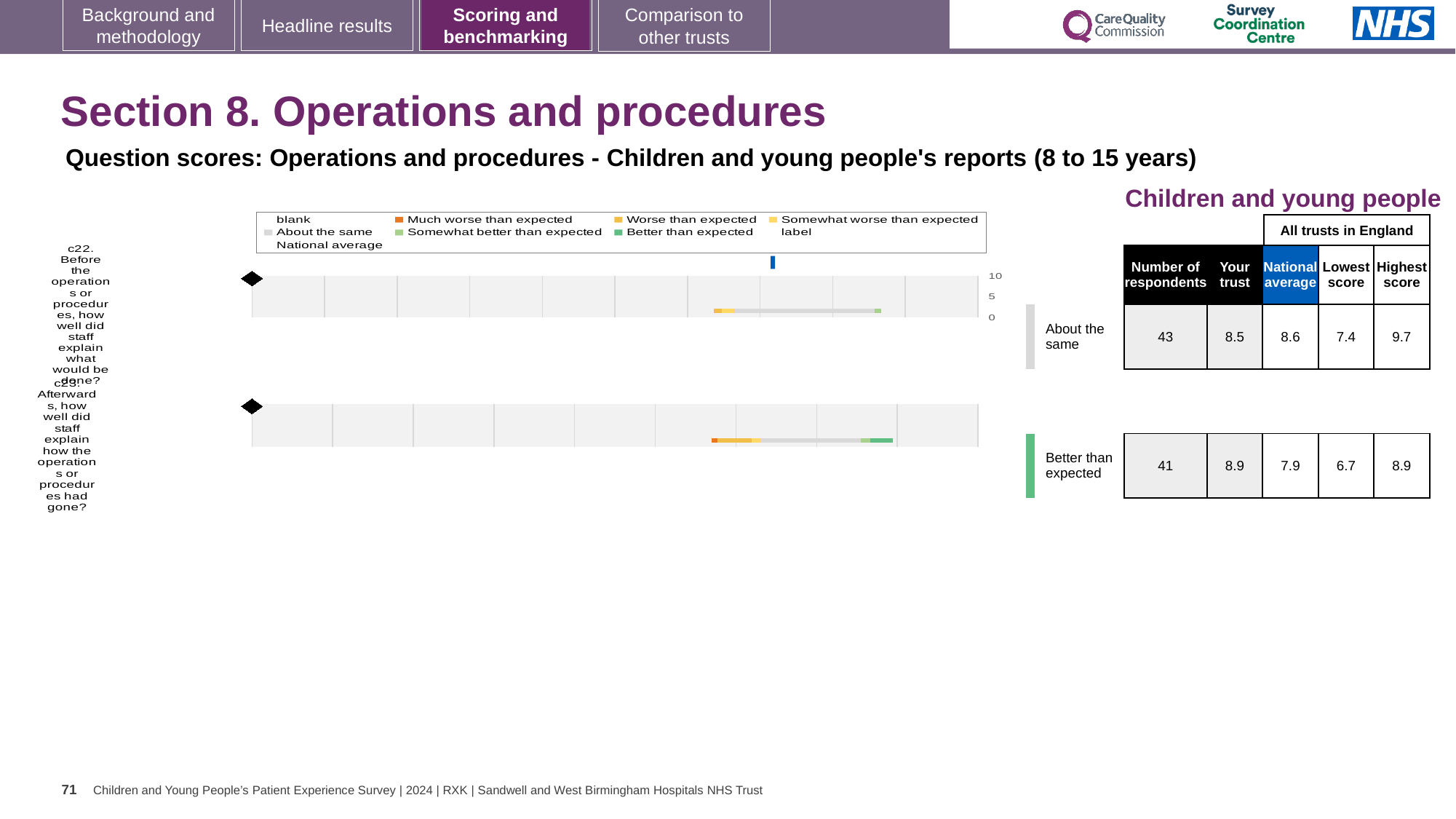
For question c23 (Afterwards, how well did staff explain how the operations or procedures had gone?), what is the 'Your trust' score? 8.9 For question c23, which is larger: the 'Your trust' score or the national average? Your trust For question c22, what is the difference between the highest score and the lowest score among all trusts in England? 2.3 For question c22 (Before the operations or procedures, how well did staff explain what would be done?), what is the 'Your trust' score? 8.5 In the chart legend, which colour represents 'Much worse than expected'? orange How many survey questions (chart rows) are plotted on the slide? 2 What kind of chart is used to show the benchmarking results for questions c22 and c23? bar chart For question c22, what is the national average score? 8.6 In the chart legend, which colour represents 'Better than expected'? green For question c23, what is the difference between the 'Your trust' score and the national average? 1.0 Is the 'Your trust' score for question c22 greater or less than 5 on the chart axis? greater For question c23, what is the lowest score among all trusts in England? 6.7